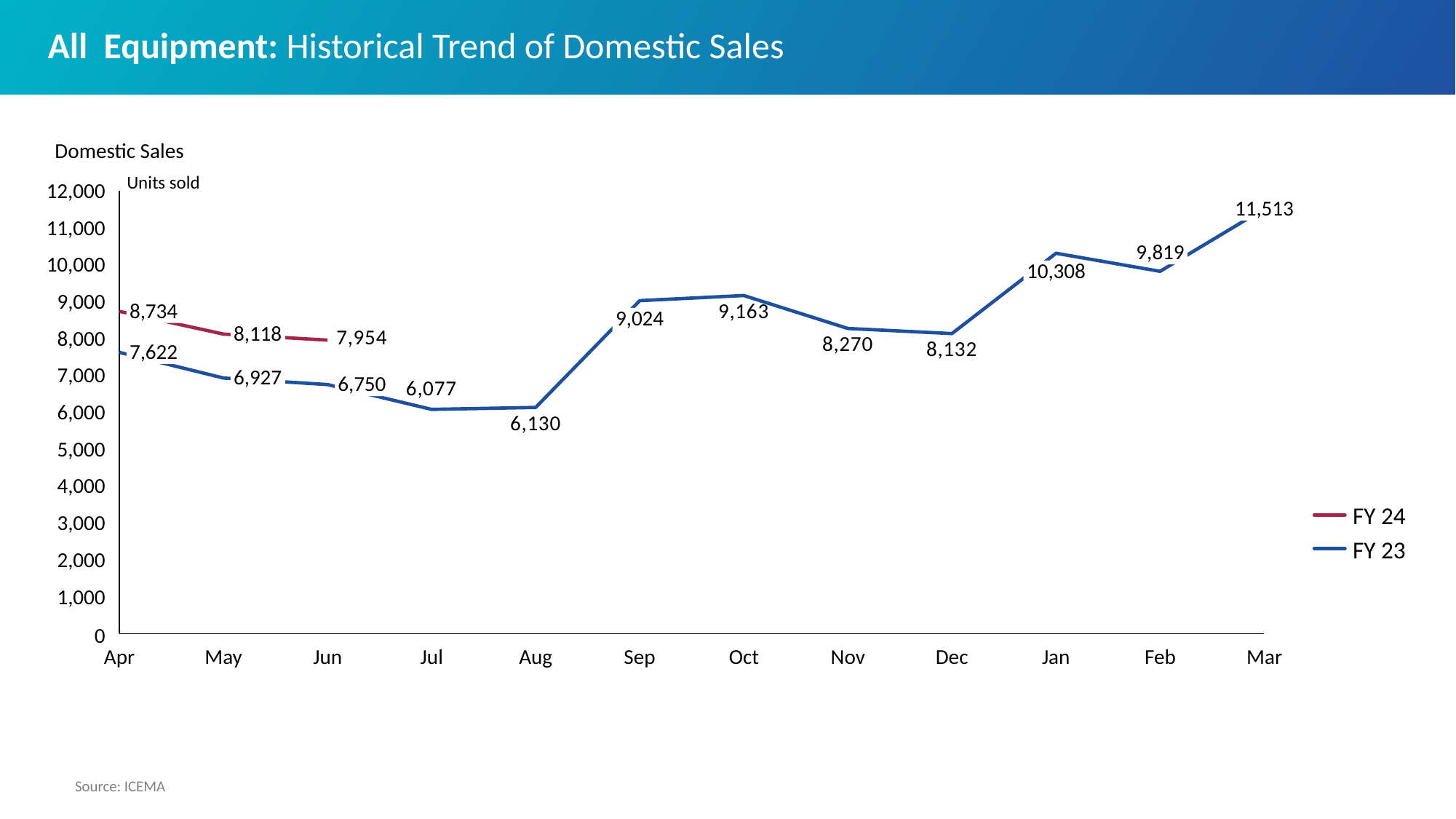
How many series does the legend list? 2 What is the FY 23 value for Apr? 7,622 Which month has the lowest FY 23 value? Jul What is the FY 24 value for Jun? 7,954 Which month has the highest FY 23 value? Mar Does the FY 24 line rise or fall from Apr to Jun? fall What kind of chart is shown? line chart What is the difference between the FY 24 and FY 23 values for May? 1,191 Is the FY 23 value for Jan greater or less than 10,000? greater What is the FY 23 value for Mar? 11,513 How many months are shown on the x axis? 12 Which is larger, the FY 23 value for Sep or the FY 23 value for Oct? Oct